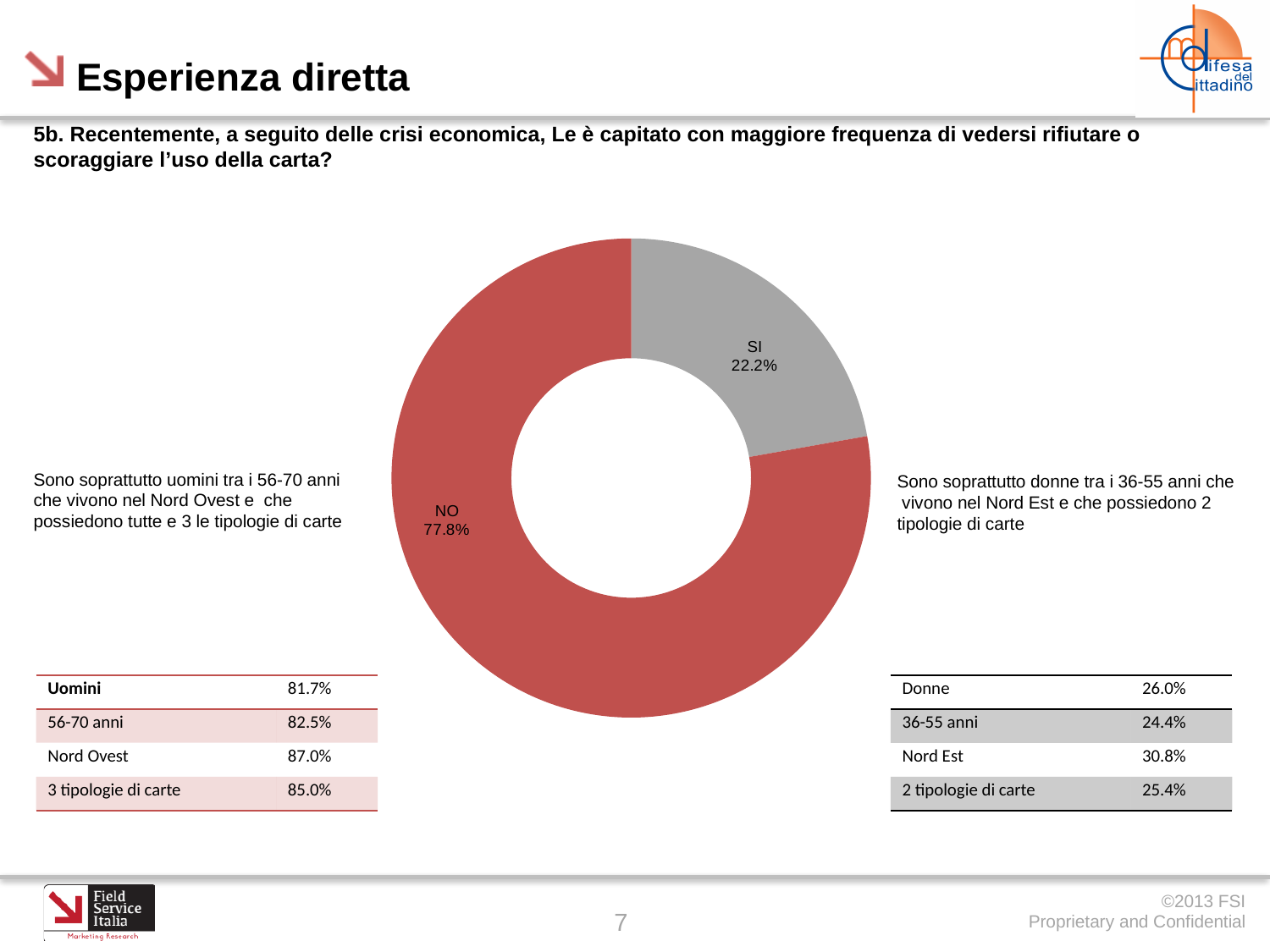
What kind of chart is shown on the slide? Donut (pie) chart How many slices does the donut chart have? 2 What colour is the SI slice of the donut chart? Grey What colour is the NO slice of the donut chart? Red What percentage of respondents answered NO in the donut chart? 77.8% Which is larger, the SI slice or the NO slice? NO What is the total of the two slices shown in the donut chart? 100% Which slice of the donut chart is the largest? NO What percentage of respondents answered SI in the donut chart? 22.2% Which slice of the donut chart is the smallest? SI What is the difference in percentage points between the NO and SI slices? 55.6